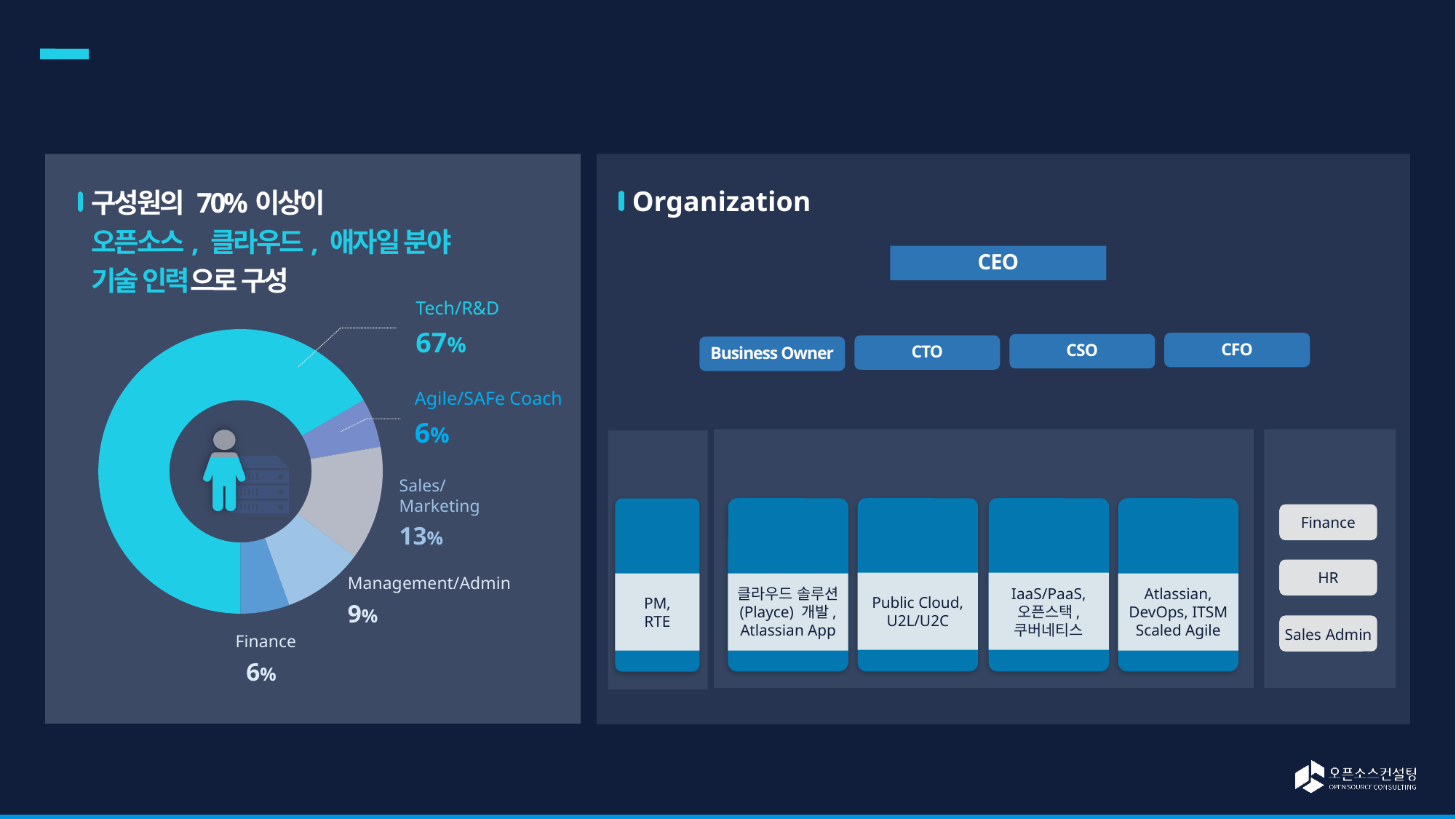
How many categories are shown in the donut chart? 5 What is the value shown for Management/Admin in the donut chart? 9% What percentage of staff is in Tech/R&D according to the donut chart? 67% Which is larger in the donut chart, Sales/Marketing or Management/Admin? Sales/Marketing What is the difference in percentage points between Tech/R&D and Sales/Marketing in the donut chart? 54 What percentage does the Sales/Marketing slice represent in the donut chart? 13% What kind of chart is shown on the left side of the slide? Pie chart (donut) Which category has the largest share in the donut chart? Tech/R&D What percentage is shown for Agile/SAFe Coach in the donut chart? 6% What percentage is shown for Finance in the donut chart? 6% What is the title of the panel on the right side of the slide containing the org chart? Organization What is the difference in percentage points between Management/Admin and Finance in the donut chart? 3